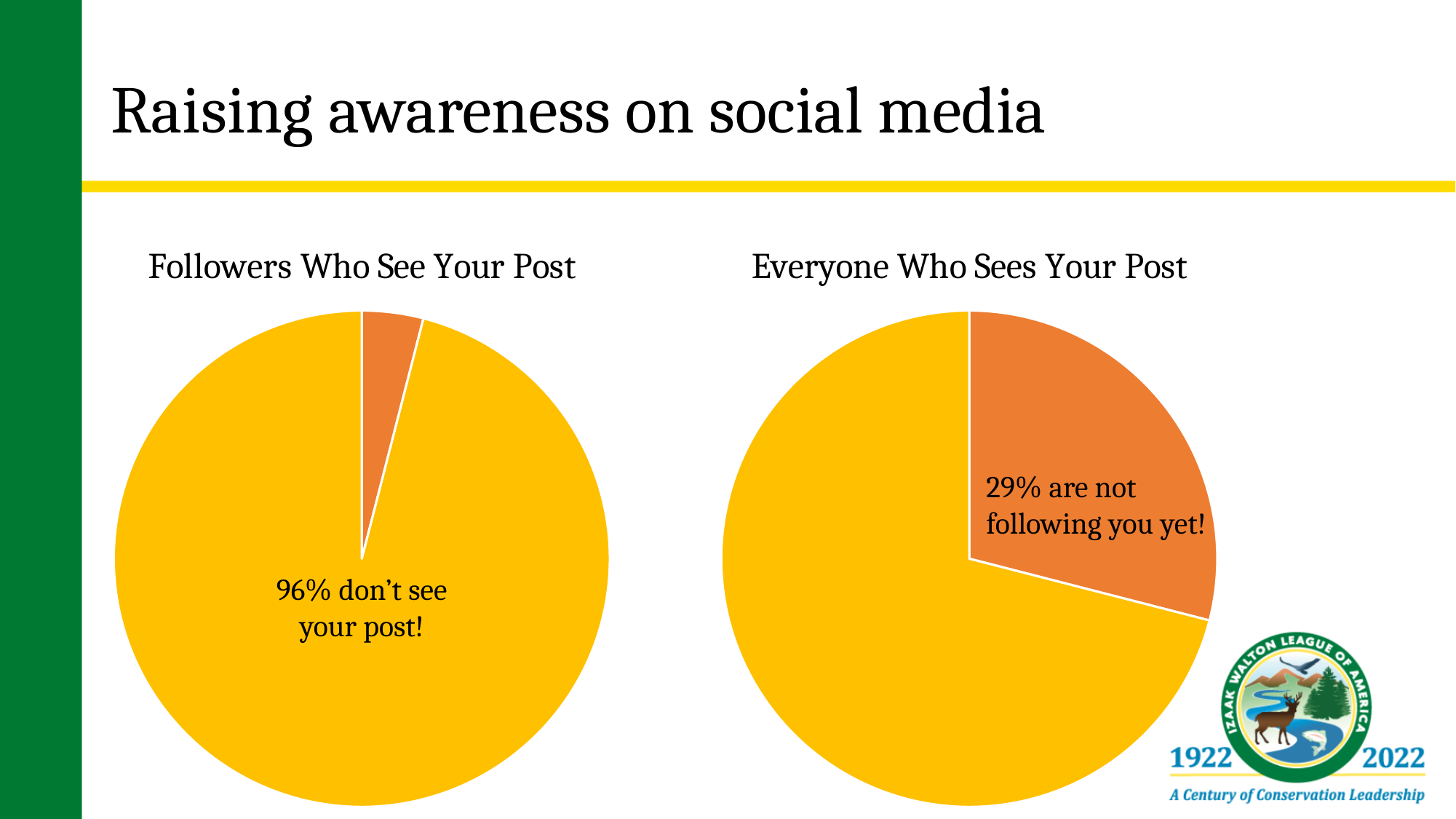
In the "Followers Who See Your Post" chart, which slice is larger, the yellow one or the orange one? the yellow one In the "Followers Who See Your Post" chart, what percentage of followers don't see your post? 96% What is the title of the pie chart on the left of the slide? Followers Who See Your Post How many slices does the "Followers Who See Your Post" pie chart have? 2 In the "Everyone Who Sees Your Post" chart, is the share of people not following you yet greater or less than 50%? less How many slices does the "Everyone Who Sees Your Post" pie chart have? 2 In the "Followers Who See Your Post" chart, is the share of followers who don't see your post greater or less than 50%? greater In the "Everyone Who Sees Your Post" chart, which slice is larger, the yellow one or the orange one? the yellow one What kind of chart is the "Followers Who See Your Post" chart? pie chart In the "Everyone Who Sees Your Post" chart, what percentage of people who see your post are not following you yet? 29% What is the title of the pie chart on the right of the slide? Everyone Who Sees Your Post What kind of chart is the "Everyone Who Sees Your Post" chart? pie chart